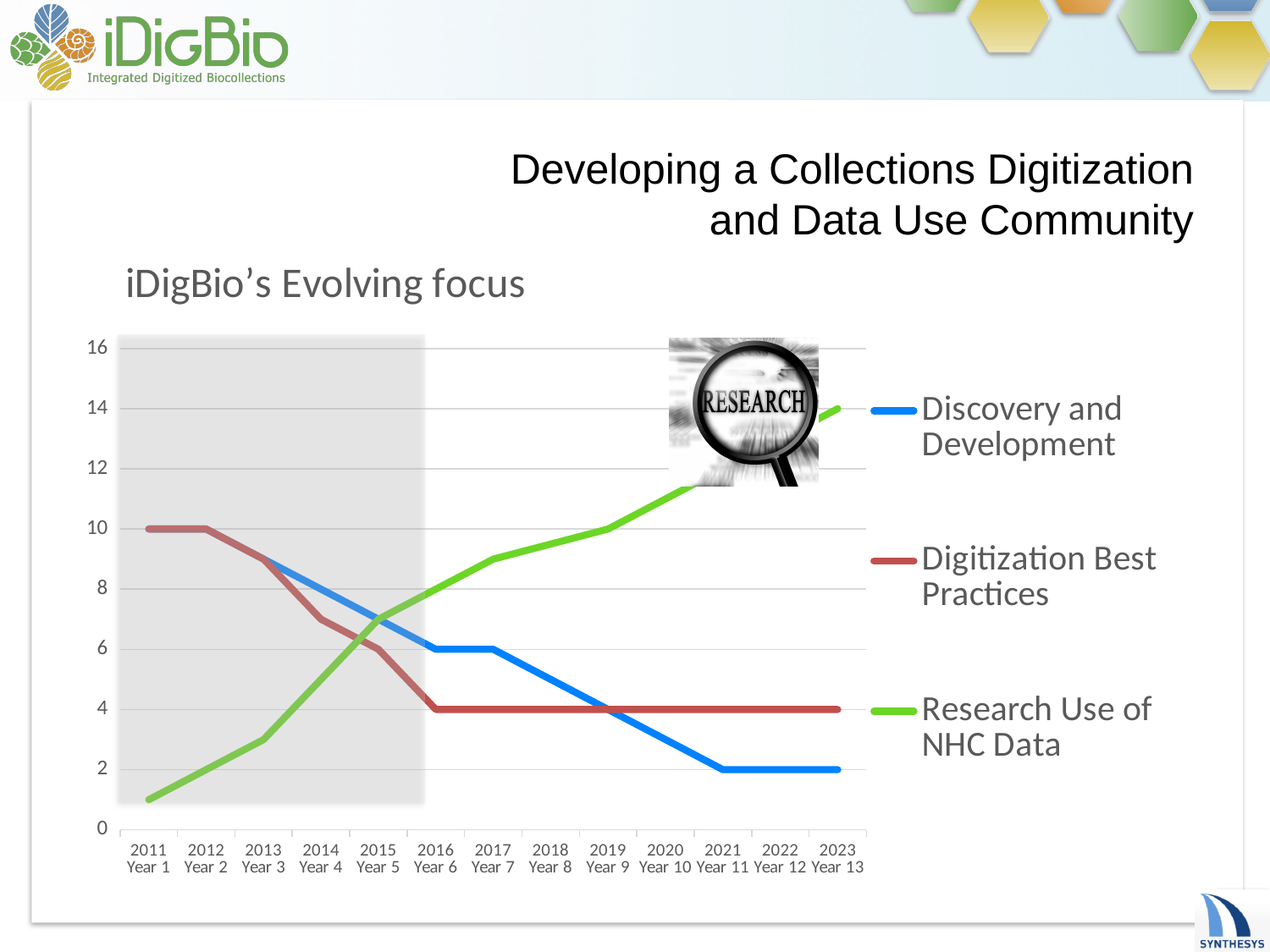
What is the value for Research Use of NHC Data in 2023 (Year 13)? 14 Is the value for Research Use of NHC Data in 2011 greater or less than 2? less Which series has the highest value in 2023? Research Use of NHC Data How many series does the legend list? 3 Does the Discovery and Development line rise or fall from 2011 to 2023? fall What is the value for Discovery and Development in 2023 (Year 13)? 2 What kind of chart is shown on the slide? line chart What is the value for Digitization Best Practices in 2023 (Year 13)? 4 In 2023, which is larger: Research Use of NHC Data or Discovery and Development? Research Use of NHC Data What is the title of the chart? iDigBio's Evolving focus Does the Research Use of NHC Data line rise or fall from 2011 to 2023? rise How many years are shown along the x axis? 13